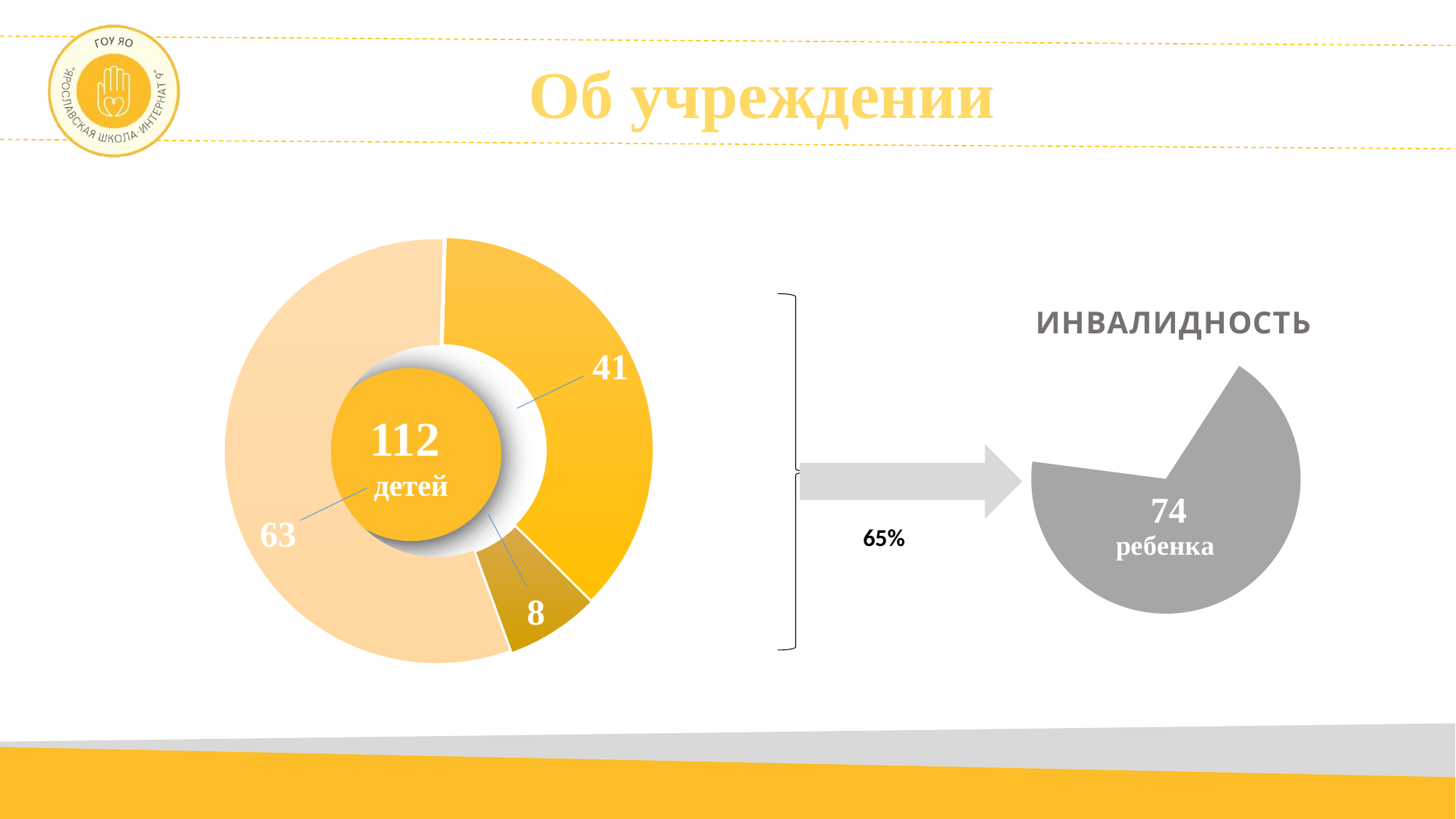
Which slice of the donut chart has the largest value? the pale slice, 63 What is the value of the dark gold (smallest) slice of the donut chart? 8 What kind of chart is shown on the left of the slide? pie (donut) chart Which slice of the donut chart has the smallest value? the dark gold slice, 8 What is the total of the three slice values in the donut chart? 112 How many slices does the donut chart on the left have? 3 What is the value of the bright yellow slice of the donut chart? 41 What is the difference between the largest slice (63) and the bright yellow slice (41) in the donut chart? 22 What is the difference between the bright yellow slice (41) and the dark gold slice (8) in the donut chart? 33 Which is larger in the donut chart: the pale slice or the bright yellow slice? the pale slice (63) What is the value of the pale (lightest) slice of the donut chart? 63 What number is printed in the centre of the donut chart? 112 детей